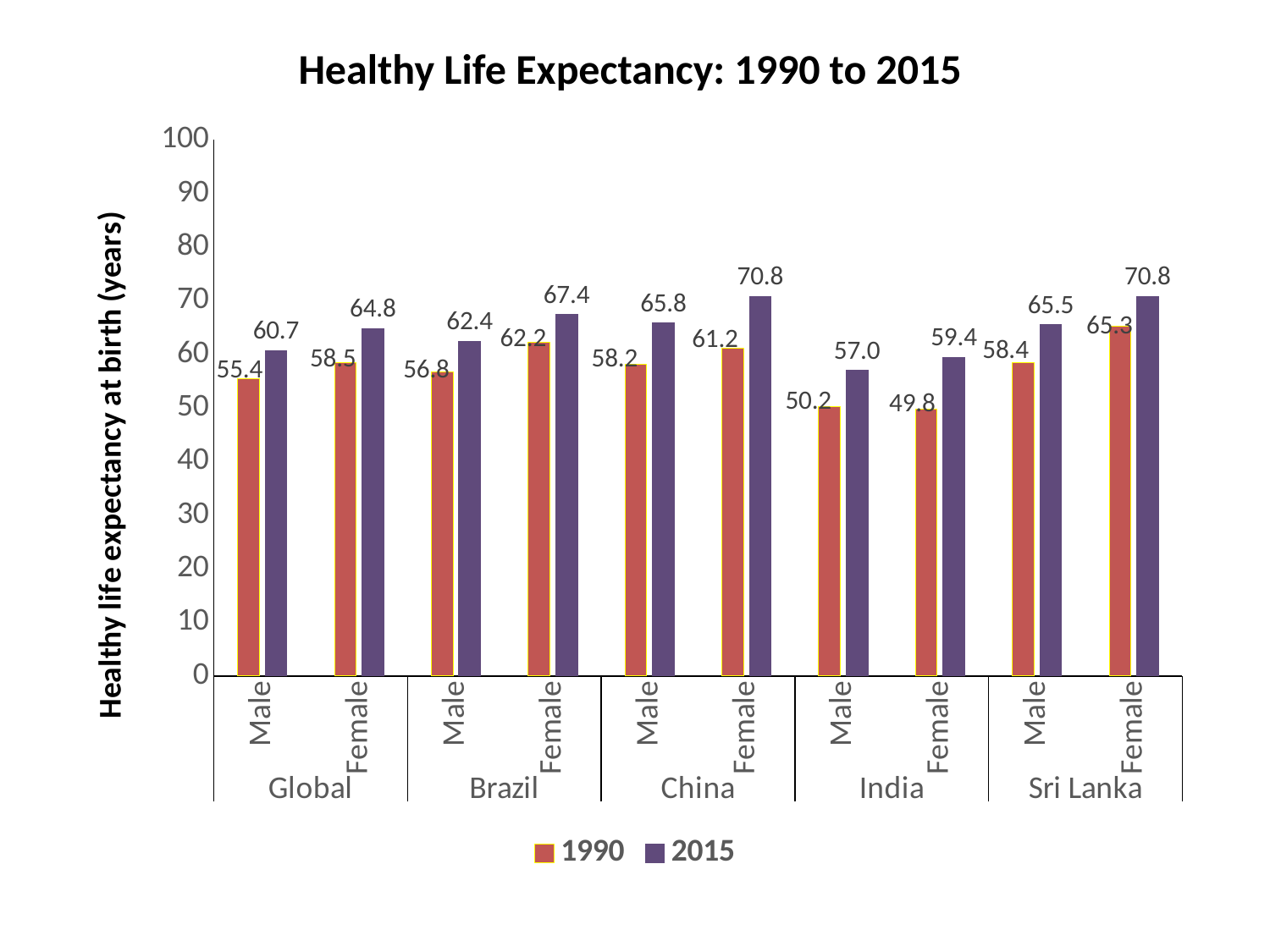
How many categories are shown on the x axis? 10 Which is larger: the 2015 value for Brazil Female or the 2015 value for China Male? Brazil Female What is the difference between the 2015 and 1990 values for India Female? 9.6 What kind of chart is this? Bar chart What is the 1990 healthy life expectancy for Sri Lanka Female? 65.3 What is the 2015 healthy life expectancy for Global Female? 64.8 How many series does the legend list? 2 What is the title of the chart? Healthy Life Expectancy: 1990 to 2015 Which category has the highest 1990 value? Sri Lanka Female What is the 1990 healthy life expectancy for India Male? 50.2 What is the 2015 healthy life expectancy for China Male? 65.8 Which category has the lowest 1990 value? India Female